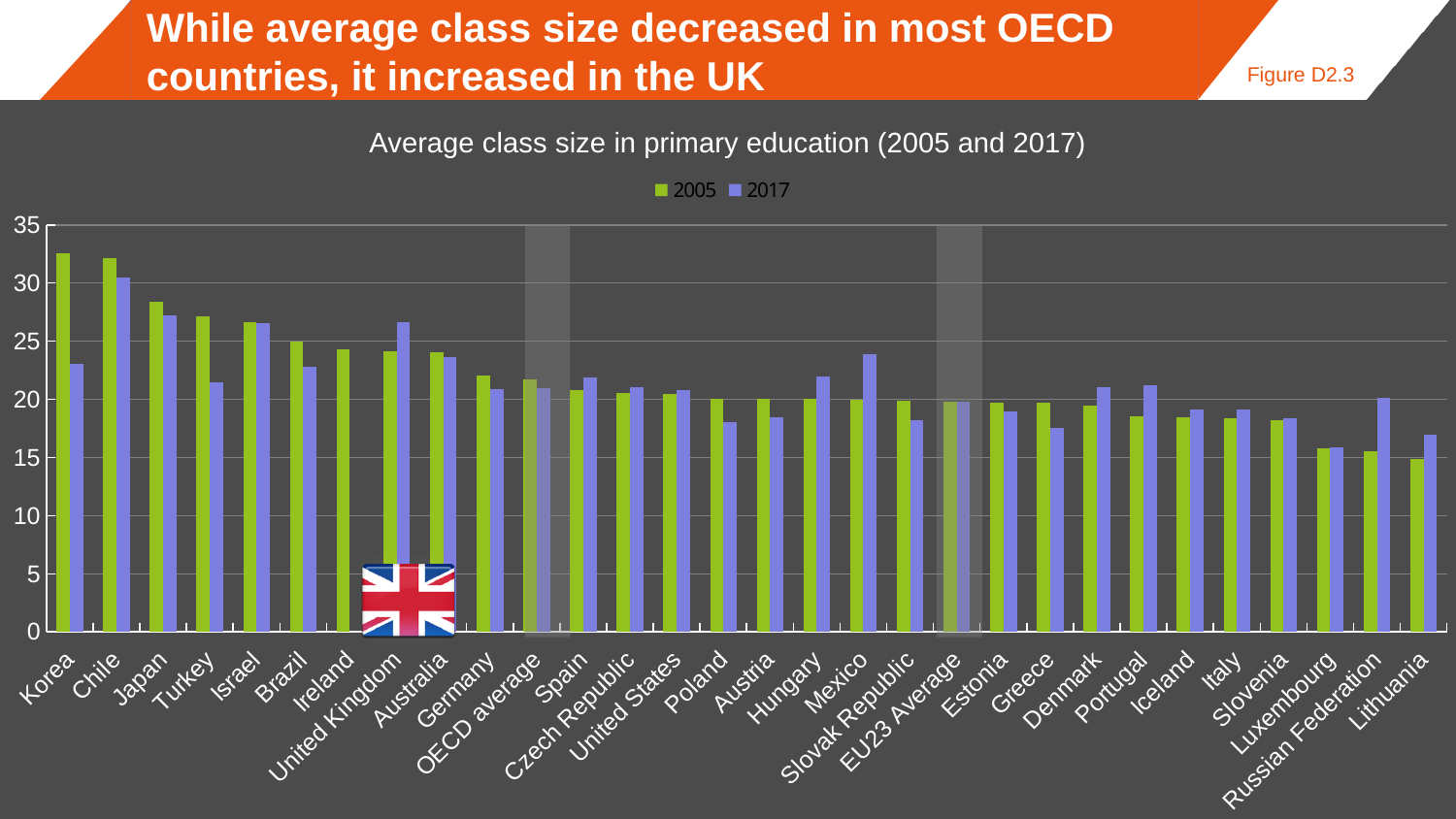
What kind of chart is shown on the slide? Bar chart How many series does the legend list? 2 For Mexico, which year has the larger average class size, 2005 or 2017? 2017 Do the 2005 values generally rise or fall moving from left to right along the x axis? fall For the United Kingdom, which year has the larger average class size, 2005 or 2017? 2017 Is the 2017 value for Korea greater or less than 25? less Which country has the highest average class size in 2017? Chile Is the 2005 value for the Russian Federation greater or less than 20? less Which country has the lowest average class size in 2017? Luxembourg Is the 2017 value for the United Kingdom greater or less than 25? greater How many countries or averages are shown along the x axis? 30